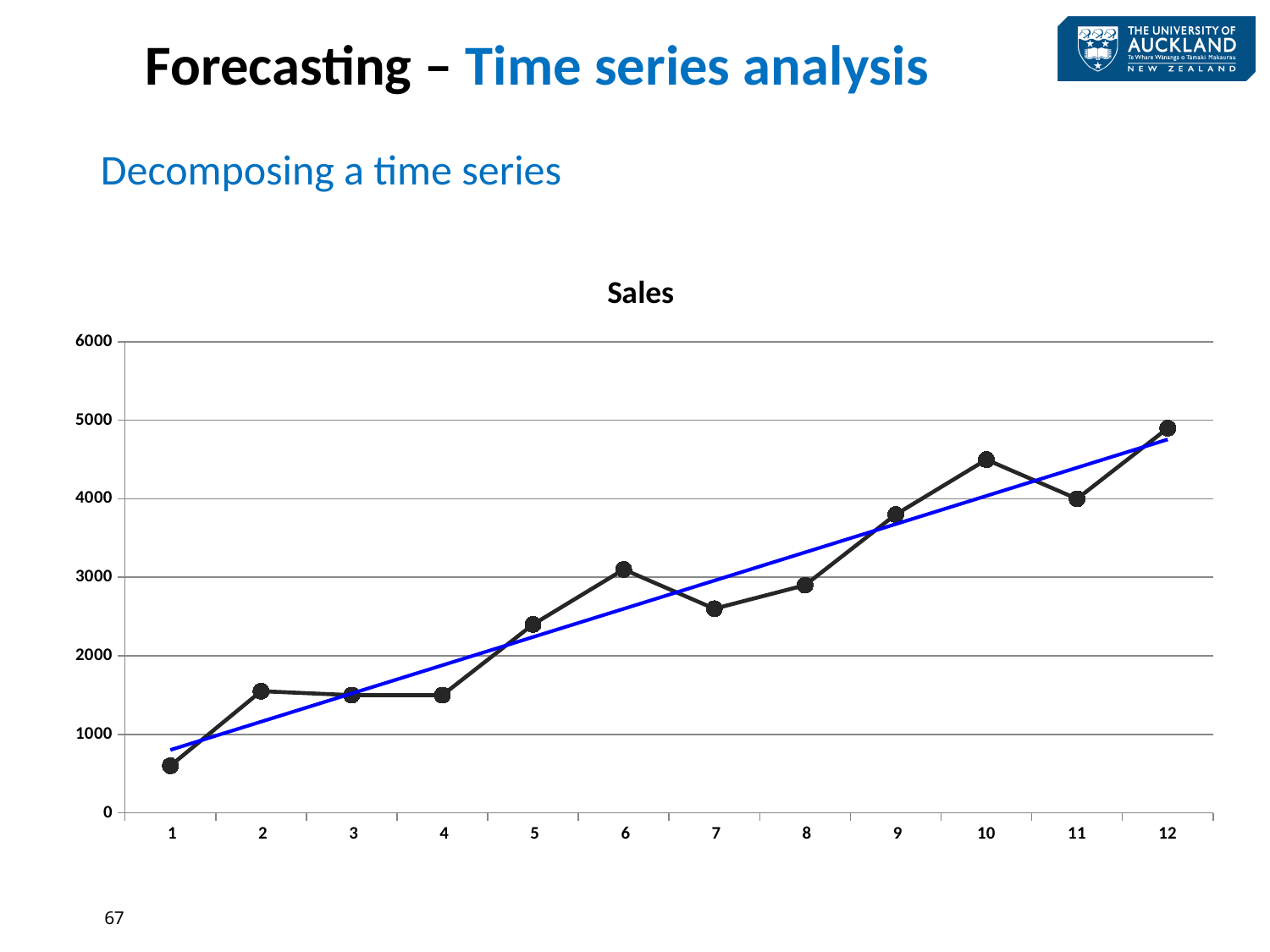
Which period has the highest sales value? 12 Is the sales value for period 10 greater or less than 4000? greater Is the sales value for period 7 greater or less than 3000? less What kind of chart is shown on the slide? line chart How many data points are plotted on the x axis? 12 Which period has the lowest sales value? 1 What is the title of the chart? Sales Is the sales value for period 1 greater or less than 1000? less Which period has the larger sales value, period 10 or period 11? 10 Overall, do the sales values rise or fall from period 1 to period 12? rise